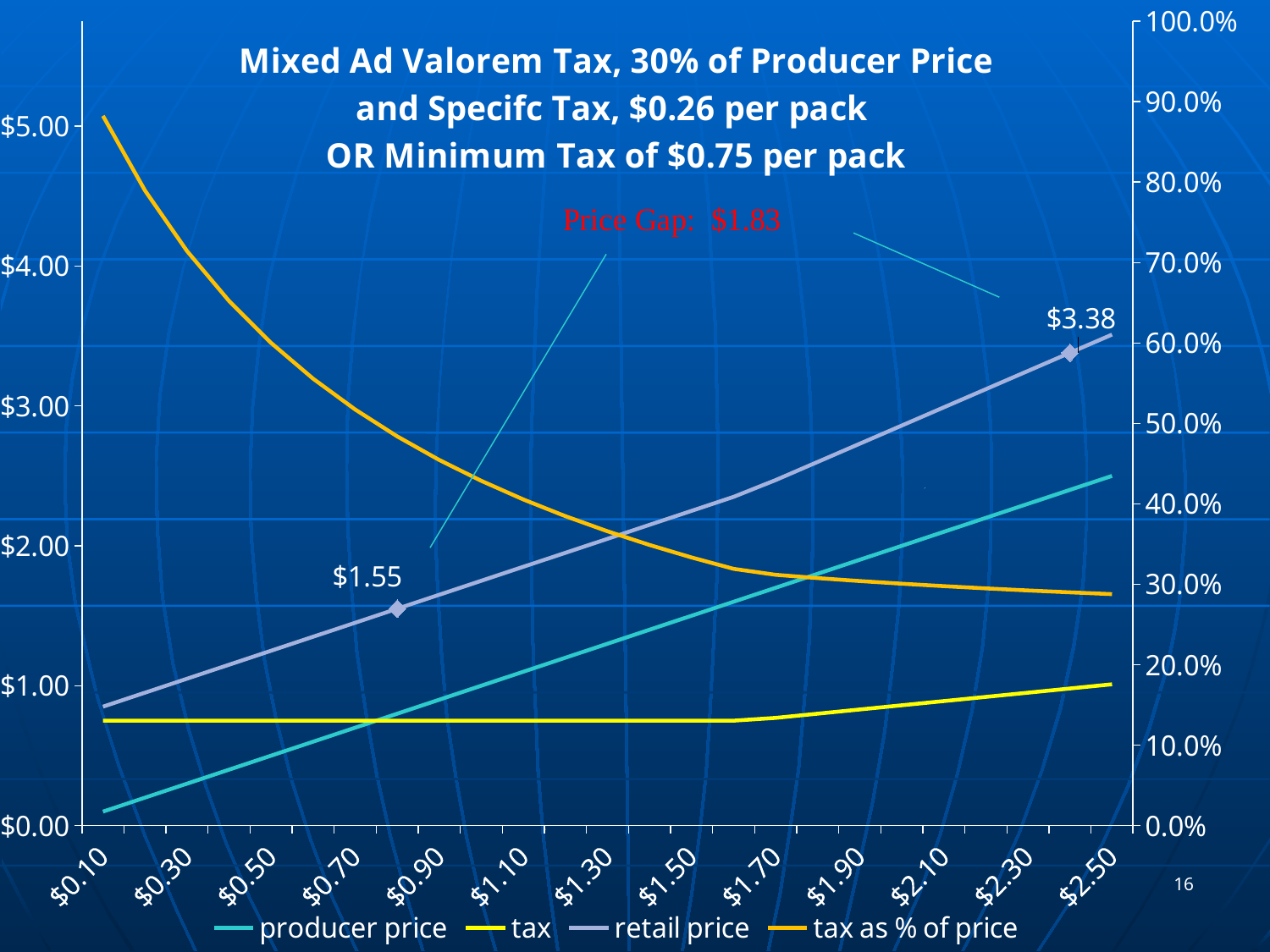
What are the series names listed in the legend? producer price, tax, retail price, tax as % of price How many price labels are shown on the x axis? 13 Is the value of tax as % of price at $0.10 greater or less than 80.0%? greater Does the tax as % of price line rise or fall as the producer price on the x axis increases? fall Is the tax value at $0.10 greater or less than $1.00? less How many series does the legend list? 4 What kind of chart is shown on the slide? line chart Does the retail price line rise or fall along the x axis? rise What price gap value is annotated on the chart? $1.83 What is the lower of the two labeled values on the retail price line? $1.55 What is the higher of the two labeled values on the retail price line? $3.38 What is the difference between the two labeled retail price values, $3.38 and $1.55? $1.83